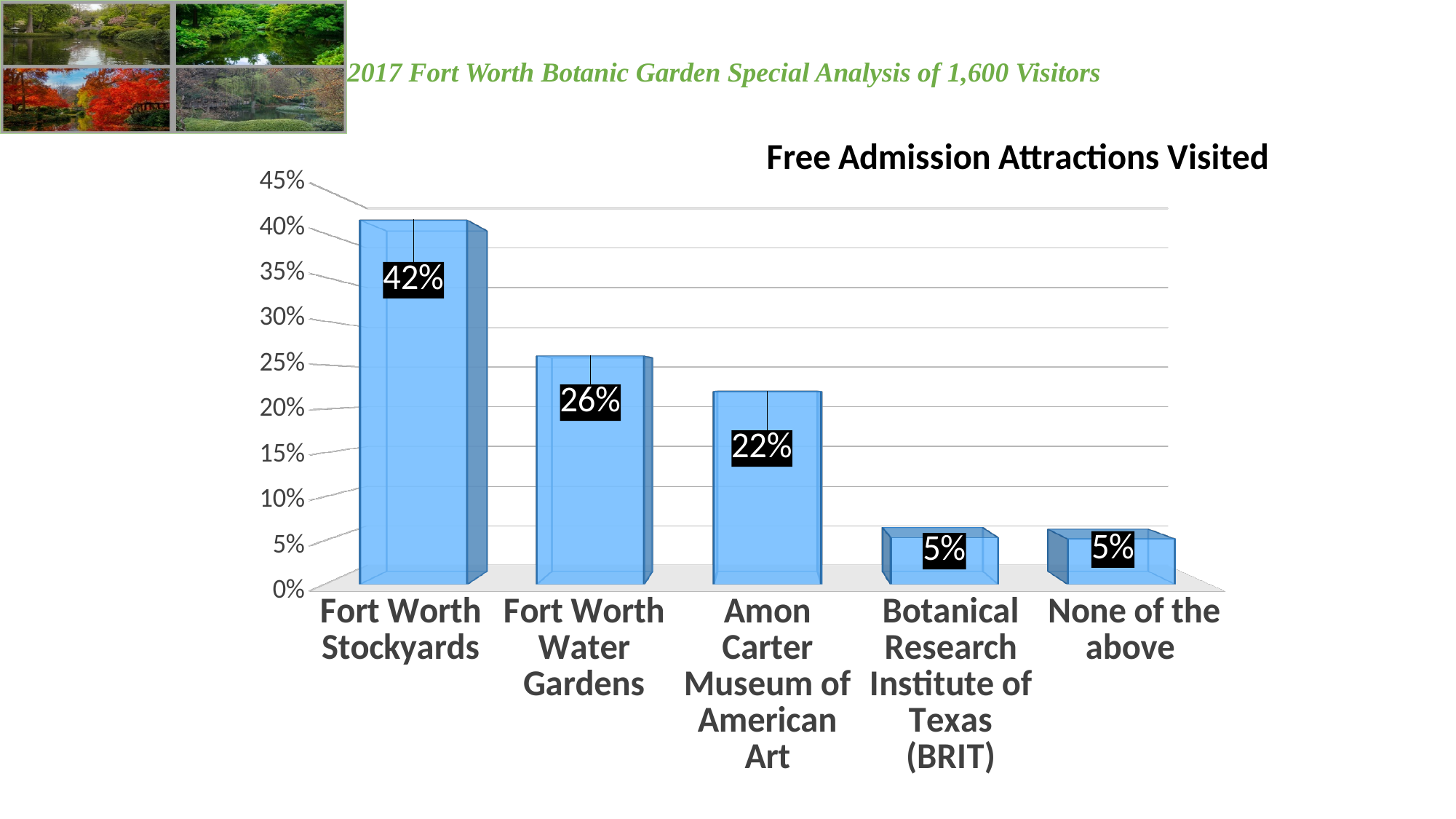
What is the difference between the values for Fort Worth Stockyards and Fort Worth Water Gardens? 16% What percentage of visitors visited the Fort Worth Stockyards? 42% Which is larger, the value for Amon Carter Museum of American Art or the value for None of the above? Amon Carter Museum of American Art What percentage is shown for the Amon Carter Museum of American Art? 22% What is the value for Botanical Research Institute of Texas (BRIT)? 5% Is the value for Fort Worth Stockyards greater or less than 40%? greater What is the value shown for Fort Worth Water Gardens? 26% Which attraction has the highest percentage of visitors? Fort Worth Stockyards What is the title of the chart? Free Admission Attractions Visited What kind of chart is shown on the slide? Bar chart What is the difference between the values for Fort Worth Water Gardens and Amon Carter Museum of American Art? 4% How many categories are shown on the x axis of the chart? 5